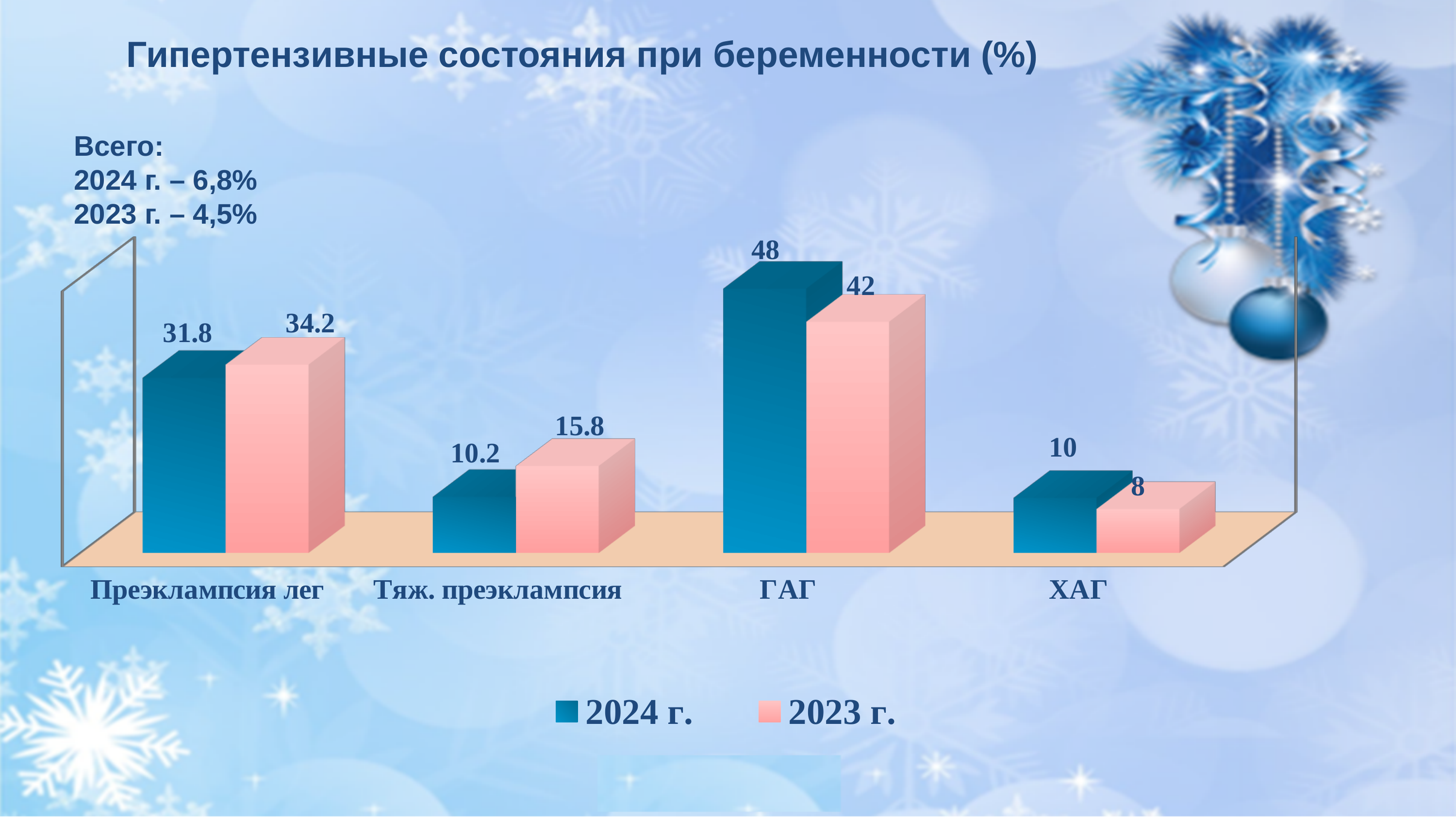
What is the value for ХАГ in the 2023 г. series? 8 What is the value for Тяж. преэклампсия in the 2023 г. series? 15.8 For Преэклампсия лег, which series has the larger value, 2024 г. or 2023 г.? 2023 г. How many categories are shown on the x axis of the chart? 4 What is the difference between the 2023 г. and 2024 г. values for Тяж. преэклампсия? 5.6 How many series does the legend list? 2 What is the difference between the 2024 г. and 2023 г. values for ГАГ? 6 What is the value for ГАГ in the 2024 г. series? 48 Which category has the highest value in the 2023 г. series? ГАГ What kind of chart is shown on the slide? Bar chart What is the value for Преэклампсия лег in the 2024 г. series? 31.8